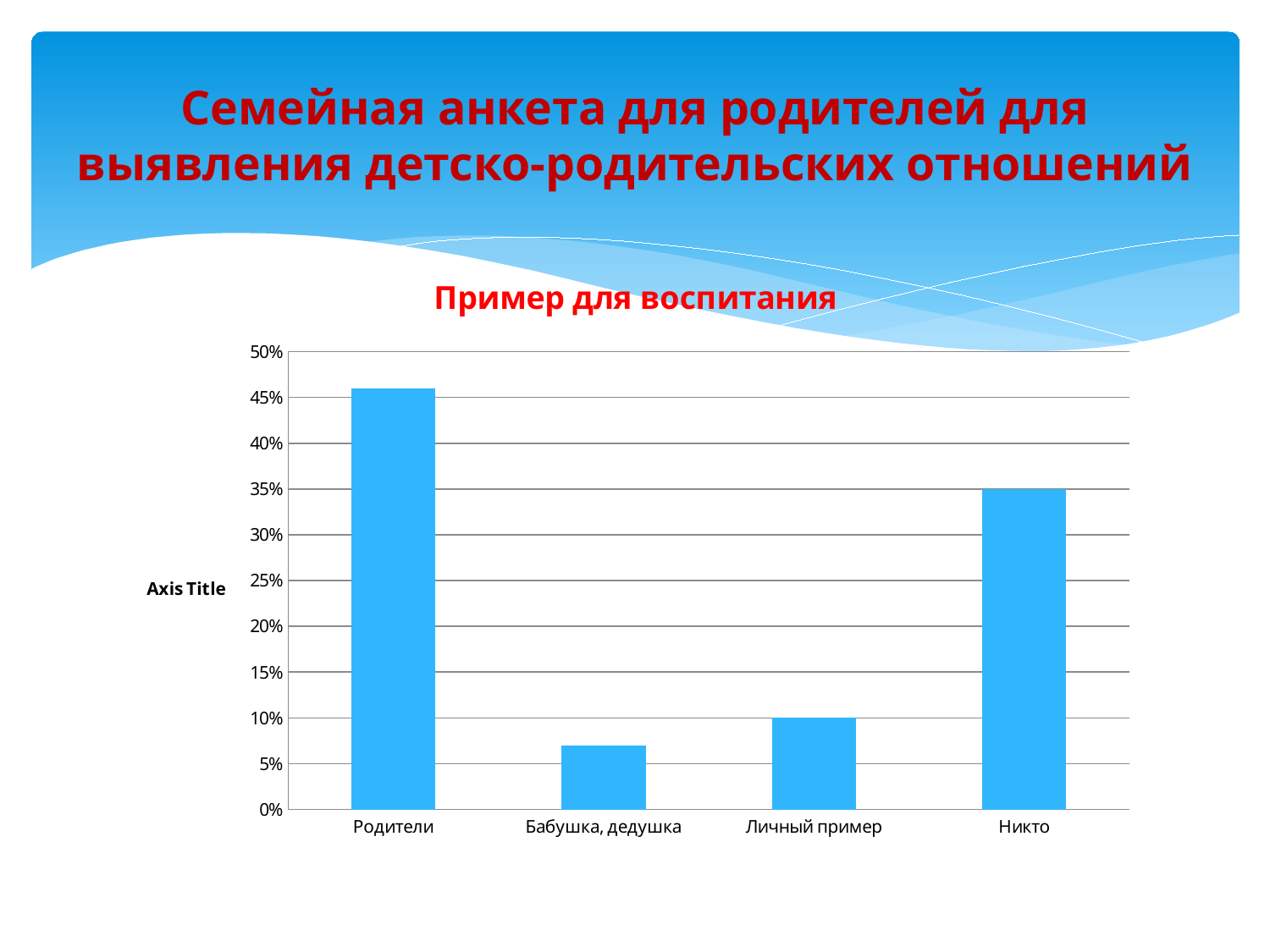
Which category has the lowest value in the chart? Бабушка, дедушка Is the value for Бабушка, дедушка greater or less than 10%? less Which category has the highest value in the chart? Родители How many categories are shown on the x axis of the chart? 4 What is the value for Никто? 35% Which is larger, the value for Родители or the value for Никто? Родители Is the value for Родители greater or less than 40%? greater What is the title of the chart? Пример для воспитания What kind of chart is shown on the slide? bar chart What is the label shown on the vertical axis of the chart? Axis Title What is the difference between the values for Никто and Личный пример? 25% What is the value for Личный пример? 10%